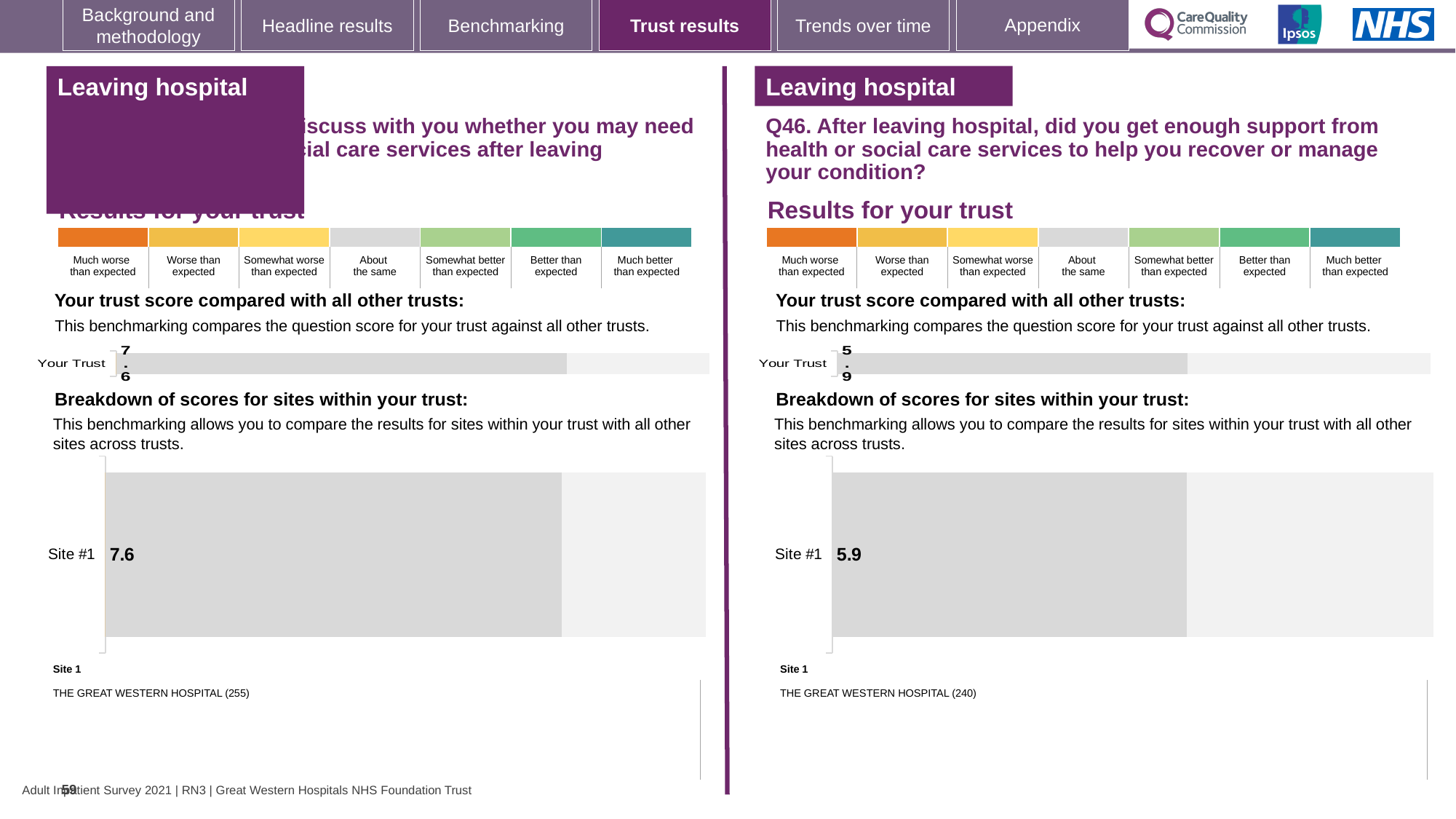
On the right half of the slide (Q46), what is the 'Your Trust' score shown in the trust benchmarking bar chart? 5.9 What type of chart is used to show the Site #1 score in the right (Q46) breakdown section? Bar chart In the right (Q46) breakdown chart, which site is labelled as Site 1 below the chart? THE GREAT WESTERN HOSPITAL (240) In the right (Q46) 'Breakdown of scores for sites within your trust' chart, what is the score for Site #1? 5.9 In the left 'Breakdown of scores for sites within your trust' chart, what is the score for Site #1? 7.6 In the left breakdown chart, which site is labelled as Site 1 below the chart? THE GREAT WESTERN HOSPITAL (255) What is the label of the single category in the left 'Your trust score compared with all other trusts' bar chart? Your Trust On the left half of the slide, what is the 'Your Trust' score shown in the trust benchmarking bar chart? 7.6 How many sites are plotted in the left 'Breakdown of scores for sites within your trust' chart? 1 What is the difference between the Site #1 score in the left breakdown chart (7.6) and the Site #1 score in the right (Q46) breakdown chart (5.9)? 1.7 Which is larger: the Site #1 score in the left breakdown chart or the Site #1 score in the right (Q46) breakdown chart? The left chart (7.6) How many sites are plotted in the right (Q46) 'Breakdown of scores for sites within your trust' chart? 1